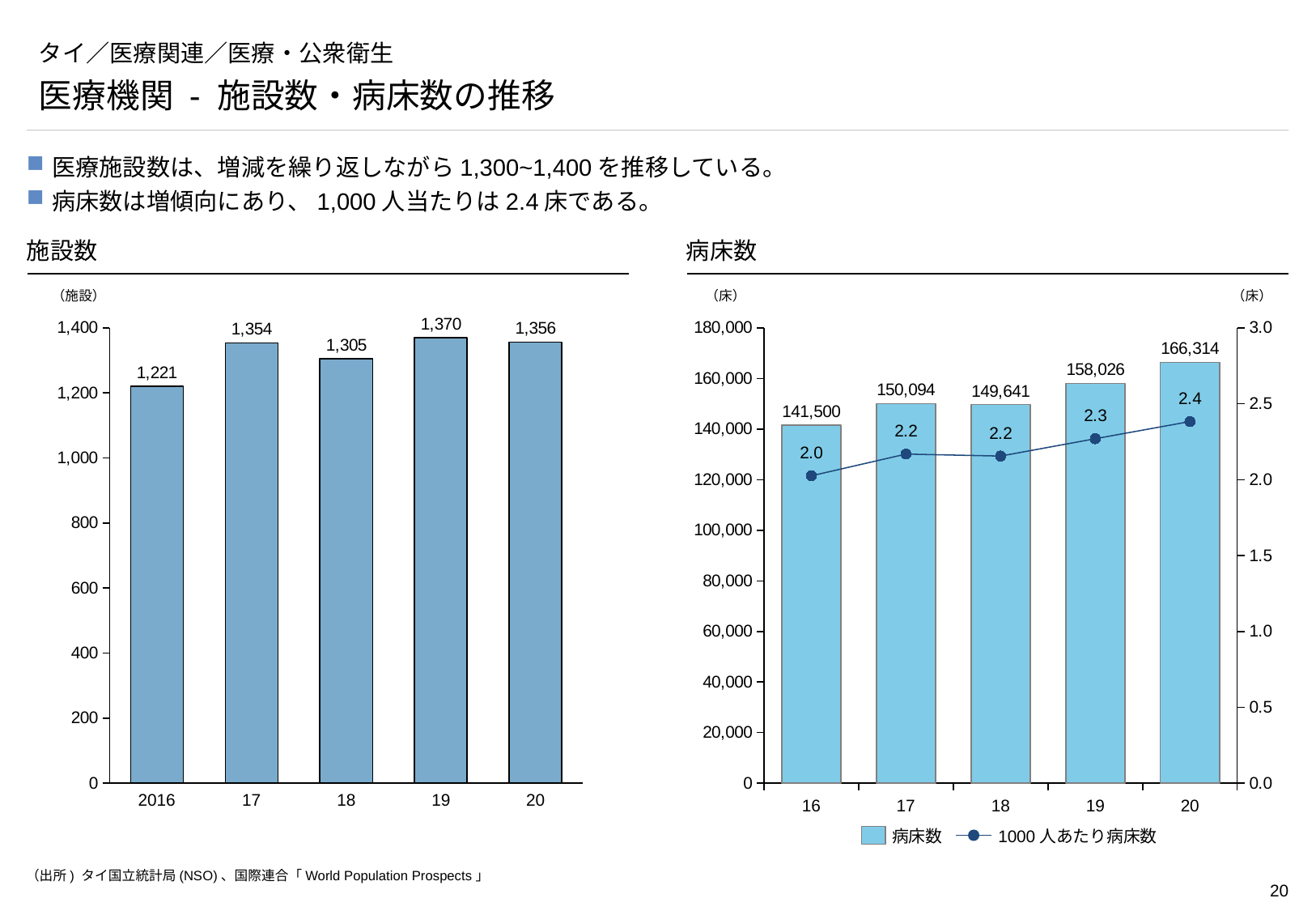
In the 施設数 chart, how many bars are plotted? 5 In the 病床数 chart, is the 病床数 value for 17 larger or smaller than the value for 18? larger In the 病床数 chart, what is the difference in 病床数 between 20 and 19? 8,288 In the 施設数 chart, which year has the highest value? 19 In the 施設数 chart, what is the difference between the values for 19 and 18? 65 In the 施設数 chart, which year has the lowest value? 2016 In the 病床数 chart, how many series does the legend list? 2 In the 病床数 chart, what is the 1000人あたり病床数 value for 16? 2.0 What kind of chart is the 施設数 chart? bar chart In the 施設数 chart, what is the value for 2016? 1,221 In the 病床数 chart, what is the 病床数 value for 20? 166,314 In the 病床数 chart, which year has the lowest 病床数 value? 16